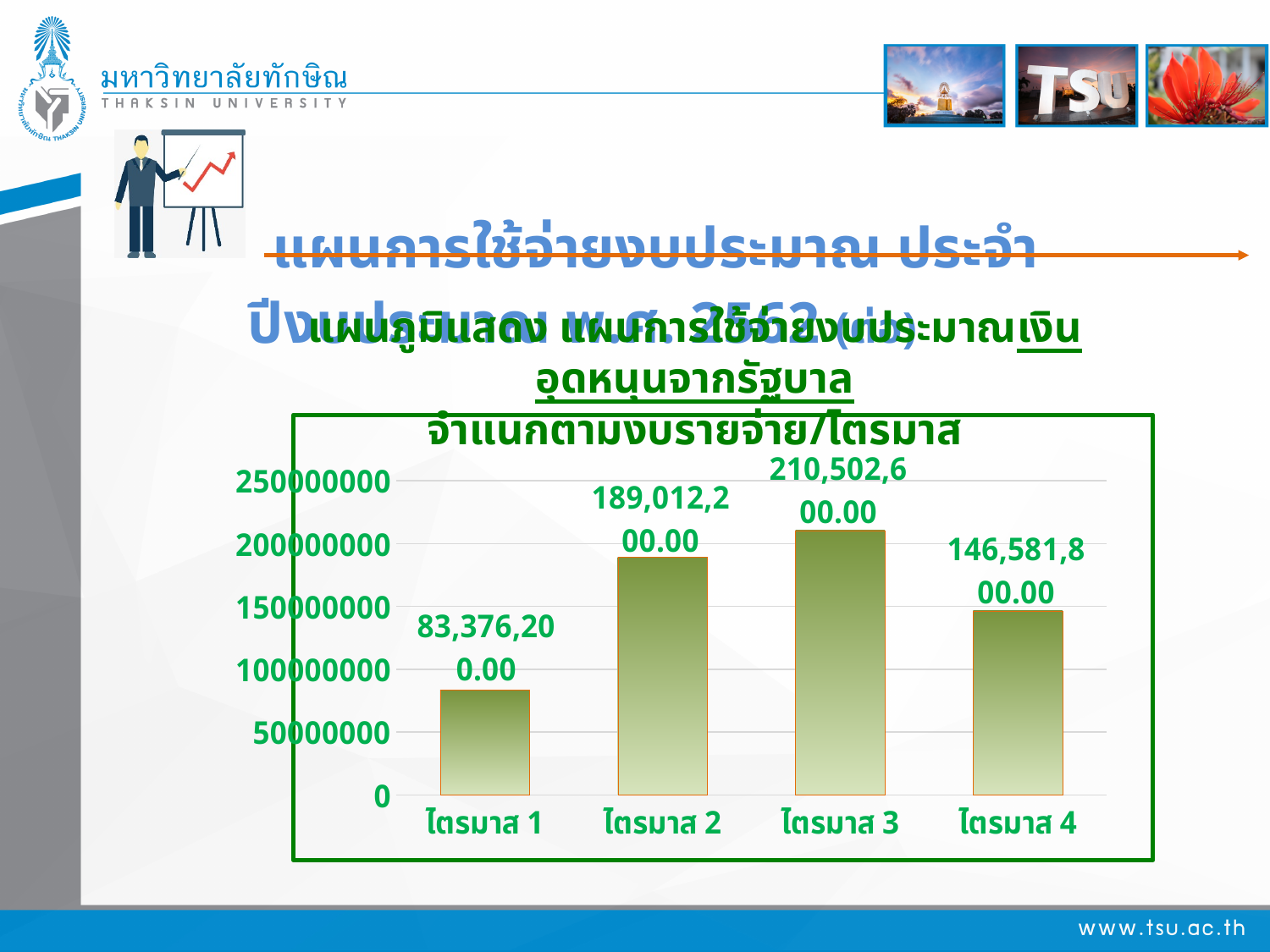
What is the value for ไตรมาส 4? 146,581,800.00 What is the value for ไตรมาส 3? 210,502,600.00 How many quarters (ไตรมาส) are plotted in the chart? 4 Which is larger, the value for ไตรมาส 2 or ไตรมาส 4? ไตรมาส 2 What type of chart is shown on the slide? bar chart What is the value for ไตรมาส 1? 83,376,200.00 What is the value for ไตรมาส 2? 189,012,200.00 Is the value for ไตรมาส 4 greater or less than 150000000? less Which quarter has the lowest value? ไตรมาส 1 What is the difference between the values for ไตรมาส 3 and ไตรมาส 2? 21,490,400.00 What is the difference between the values for ไตรมาส 2 and ไตรมาส 1? 105,636,000.00 Which quarter has the highest value? ไตรมาส 3